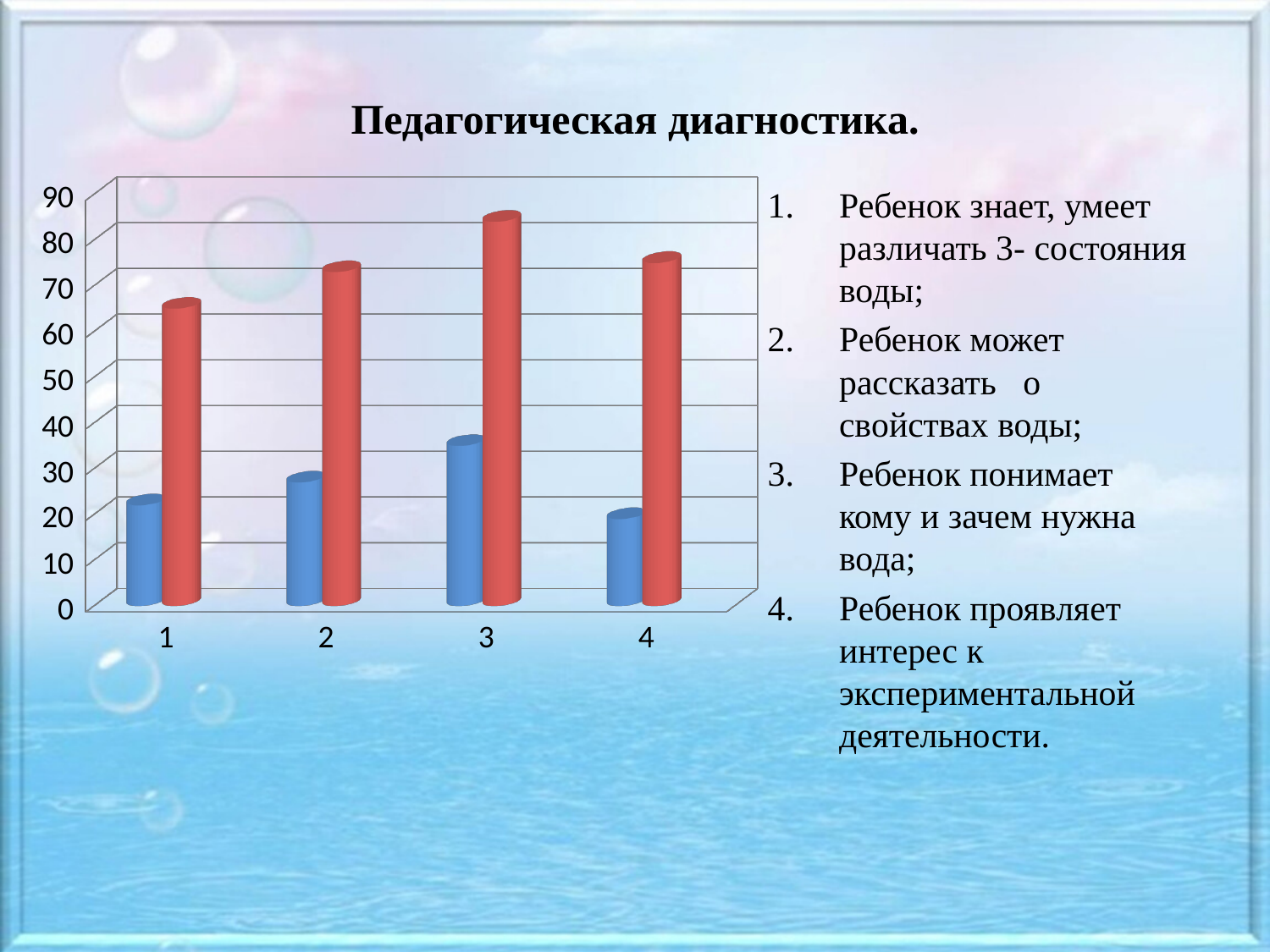
For which category is the red bar the shortest? 1 In category 1, which bar is taller, the blue one or the red one? red How many series of bars are plotted for each category? 2 Is the blue bar for category 1 greater or less than 30? less Do the red bars rise or fall from category 1 to category 3? rise What kind of chart is shown on the slide? bar chart For which category is the blue bar the tallest? 3 For which category is the red bar the tallest? 3 How many categories are shown on the x axis of the chart? 4 Is the red bar for category 3 greater or less than 70? greater What two colours are used for the bars in the chart? blue and red What is the title of the slide above the chart? Педагогическая диагностика.